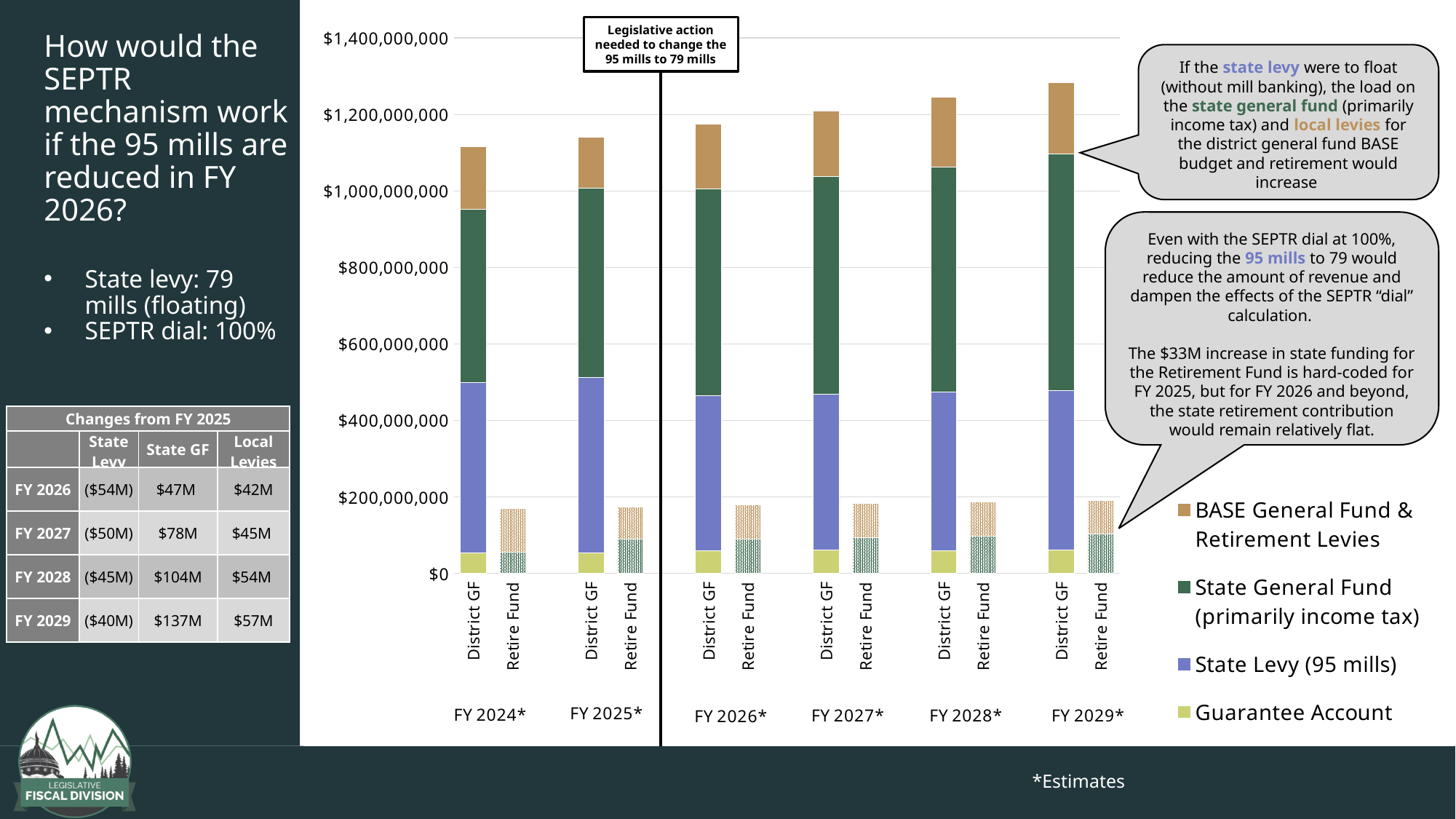
Do the District GF bar totals rise or fall from FY 2024* to FY 2029*? rise Which bar in the chart is the tallest? District GF, FY 2029* Is the total for the District GF bar in FY 2024* greater or less than $1,000,000,000? greater Is the total for the District GF bar in FY 2029* greater or less than $1,200,000,000? greater Which legend series is shown in blue in the chart? State Levy (95 mills) What kind of chart is shown on the slide? Stacked bar chart How many series does the chart legend list? 4 How many fiscal years are shown along the x axis of the chart? 6 Which is larger, the District GF bar for FY 2029* or the District GF bar for FY 2024*? District GF for FY 2029* How many bars are plotted in the chart? 12 Is the total for the District GF bar in FY 2026* greater or less than $1,200,000,000? less